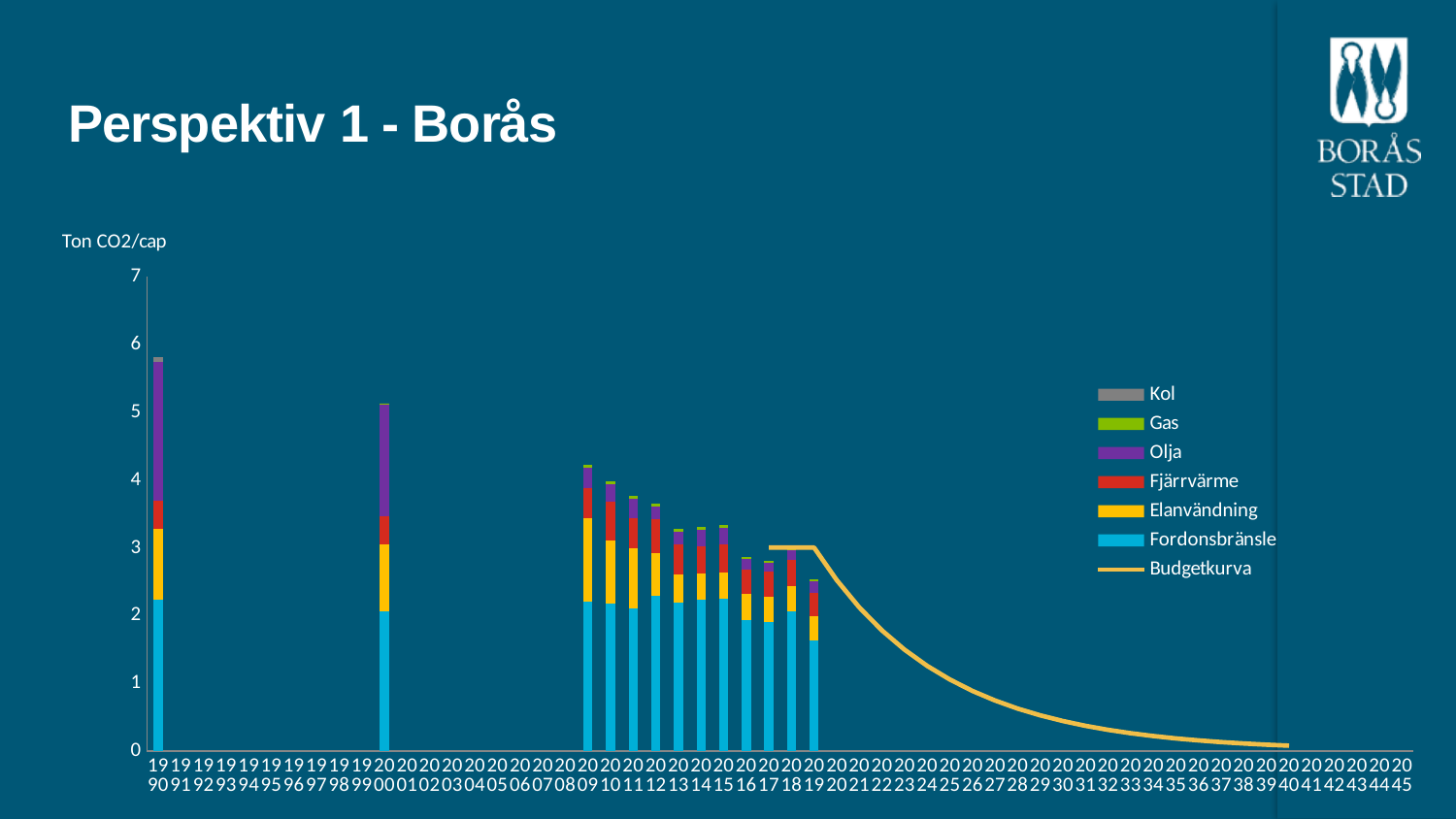
What kind of chart is shown on the slide? Stacked bar chart with a line What unit is shown on the vertical axis of the chart? Ton CO2/cap Is the total for 2013 greater or less than 4 Ton CO2/cap? less Does the Budgetkurva line rise or fall from 2019 to 2045? fall How many series does the legend list? 7 Is the total for 1990 greater or less than 5 Ton CO2/cap? greater How many years have a bar plotted in the chart? 13 Do the total bar heights rise or fall from 2009 to 2019? fall Which year has the highest total bar? 1990 Is the total for 2019 greater or less than 3 Ton CO2/cap? less Which year has the larger total bar, 1990 or 2000? 1990